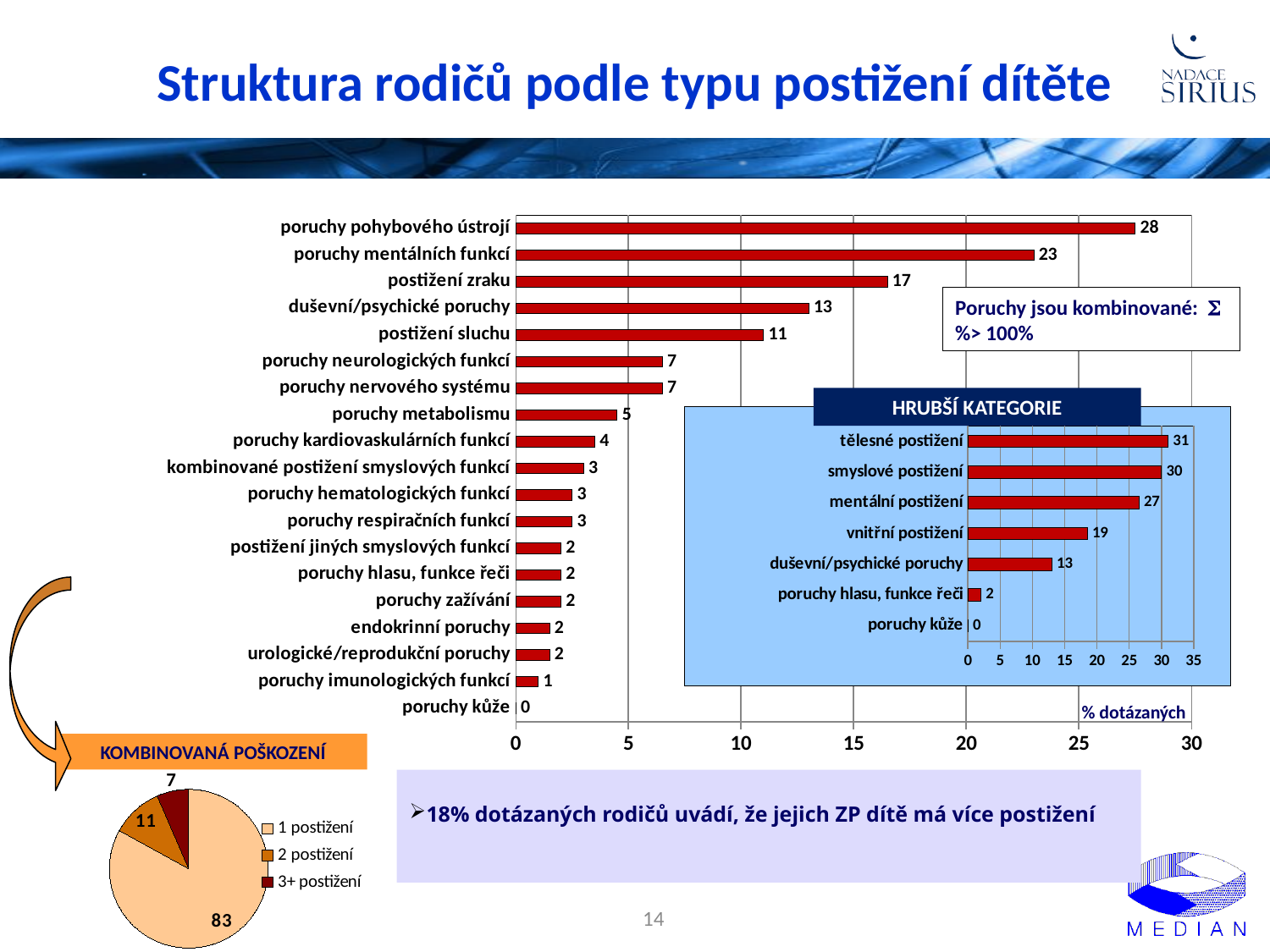
In the KOMBINOVANÁ POŠKOZENÍ pie chart, how many entries does the legend list? 3 In the large bar chart on the left, which category has the highest value? poruchy pohybového ústrojí In the large bar chart on the left, what is the difference between poruchy mentálních funkcí and postižení zraku? 6 In the large bar chart on the left, which category has the lowest value? poruchy kůže In the large bar chart on the left, what is the value for poruchy pohybového ústrojí? 28 In the large bar chart on the left, how many categories are plotted? 19 In the KOMBINOVANÁ POŠKOZENÍ pie chart, what is the value for 2 postižení? 11 In the large bar chart on the left, what is the value for postižení sluchu? 11 In the HRUBŠÍ KATEGORIE chart, what is the value for vnitřní postižení? 19 In the HRUBŠÍ KATEGORIE chart, which category has the highest value? tělesné postižení In the HRUBŠÍ KATEGORIE chart, how many categories are plotted? 7 What kind of chart is the large chart on the left? bar chart